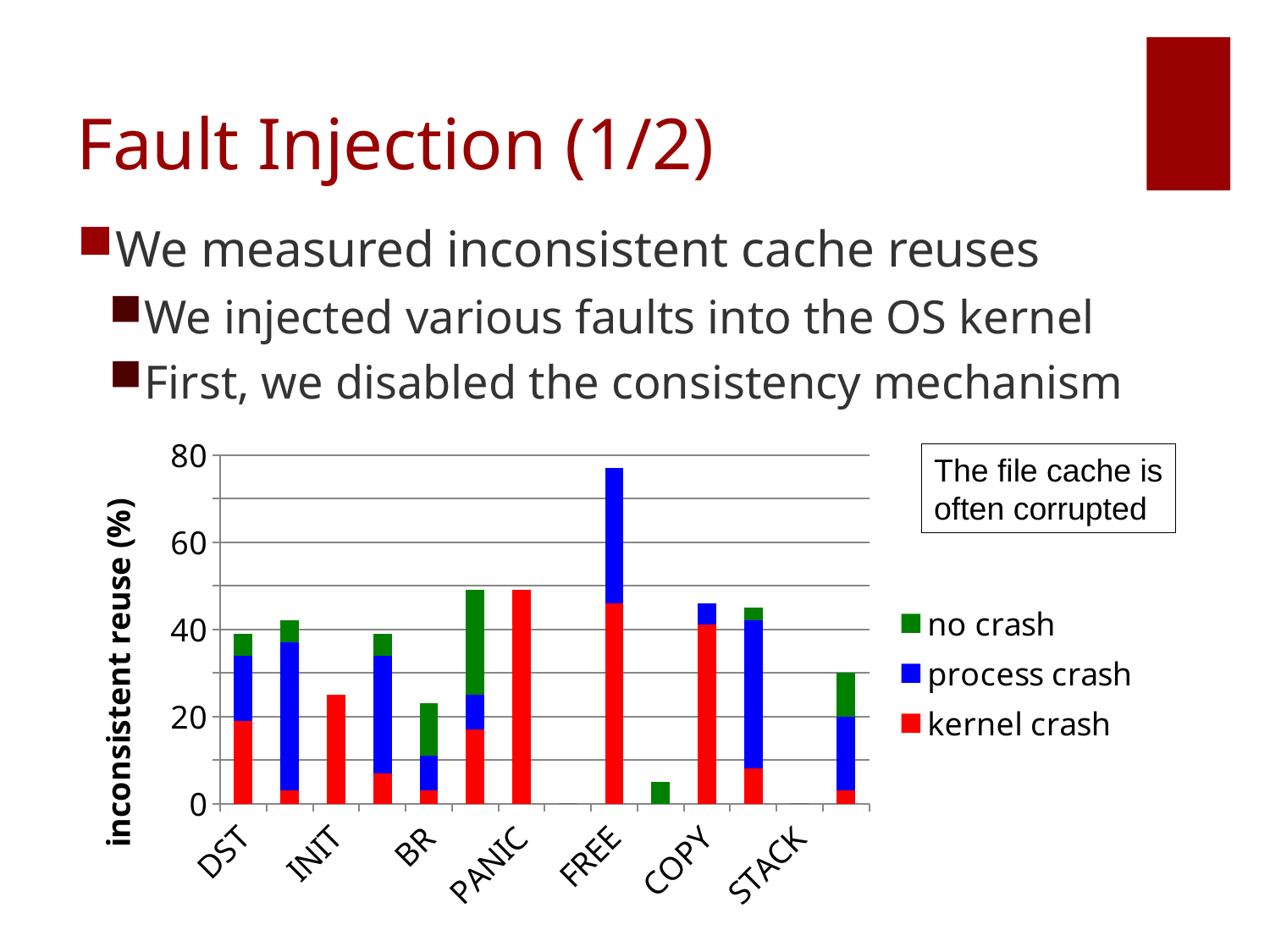
Which is larger, the total bar for PANIC or the total bar for INIT? PANIC How many series does the chart's legend list? 3 Is the total value of the bar for PANIC greater or less than 40? greater Is the total value of the bar for FREE greater or less than 60? greater What kind of chart is shown on the slide? stacked bar chart Is the total value of the bar for DST greater or less than 20? greater What is the title of the chart's vertical axis? inconsistent reuse (%) What are the three series named in the chart's legend? no crash, process crash, kernel crash Which labeled category has the tallest bar in the chart? FREE Which is larger, the total bar for FREE or the total bar for INIT? FREE